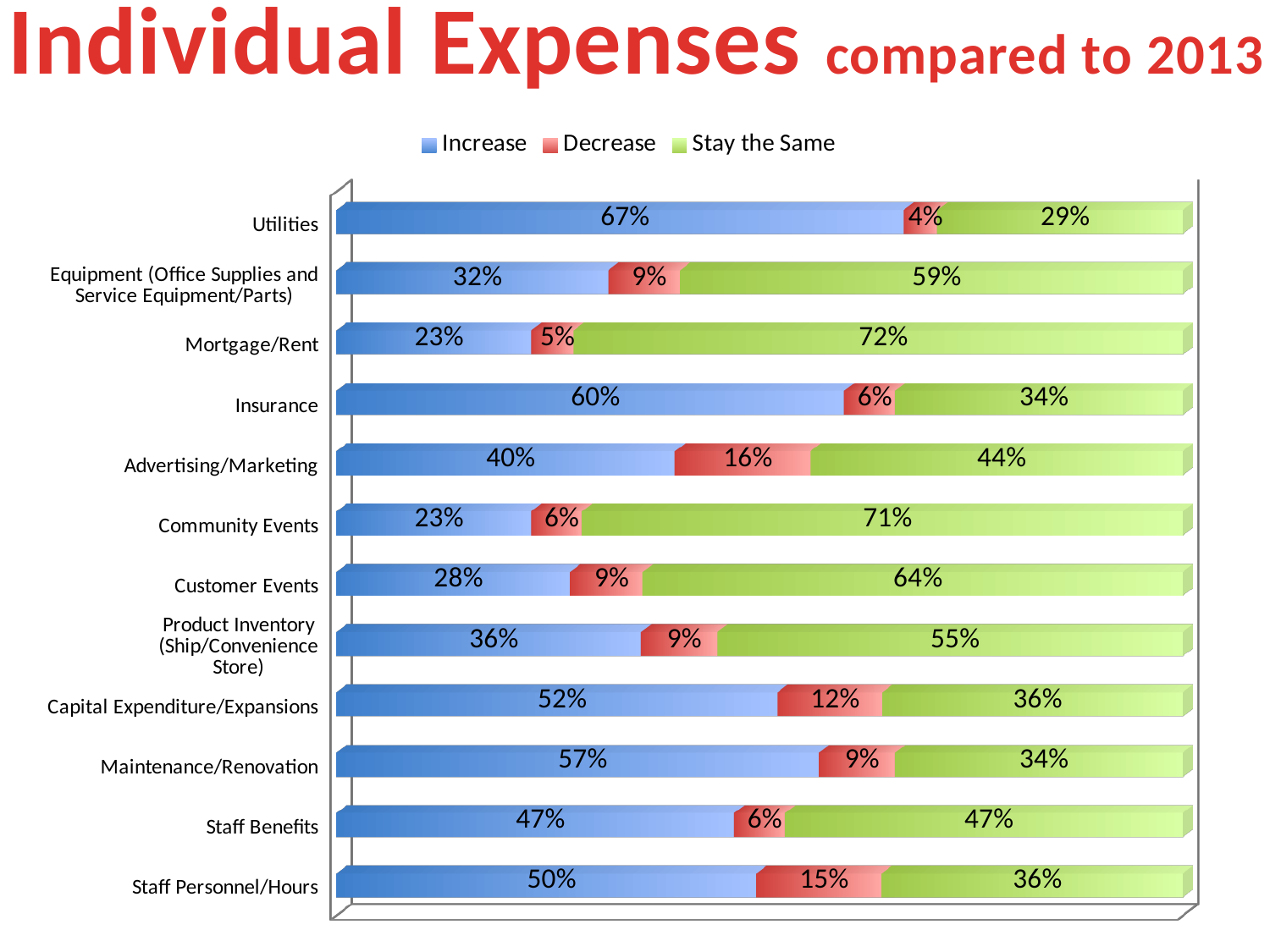
What is the total of the Increase, Decrease and Stay the Same values for Capital Expenditure/Expansions? 100% What is the difference between the Increase and Stay the Same values for Staff Personnel/Hours? 14% Which category has the lowest Decrease value? Utilities Which colour represents the Decrease series in the chart? Red What is the Decrease value for Advertising/Marketing? 16% Which category has the highest Increase value? Utilities How many series does the legend list? 3 What is the Stay the Same value for Mortgage/Rent? 72% What percentage of respondents reported an Increase in Utilities expenses? 67% Which is larger for Insurance: the Increase value or the Stay the Same value? Increase What kind of chart is shown on the slide? Stacked bar chart How many expense categories are shown in the chart? 12